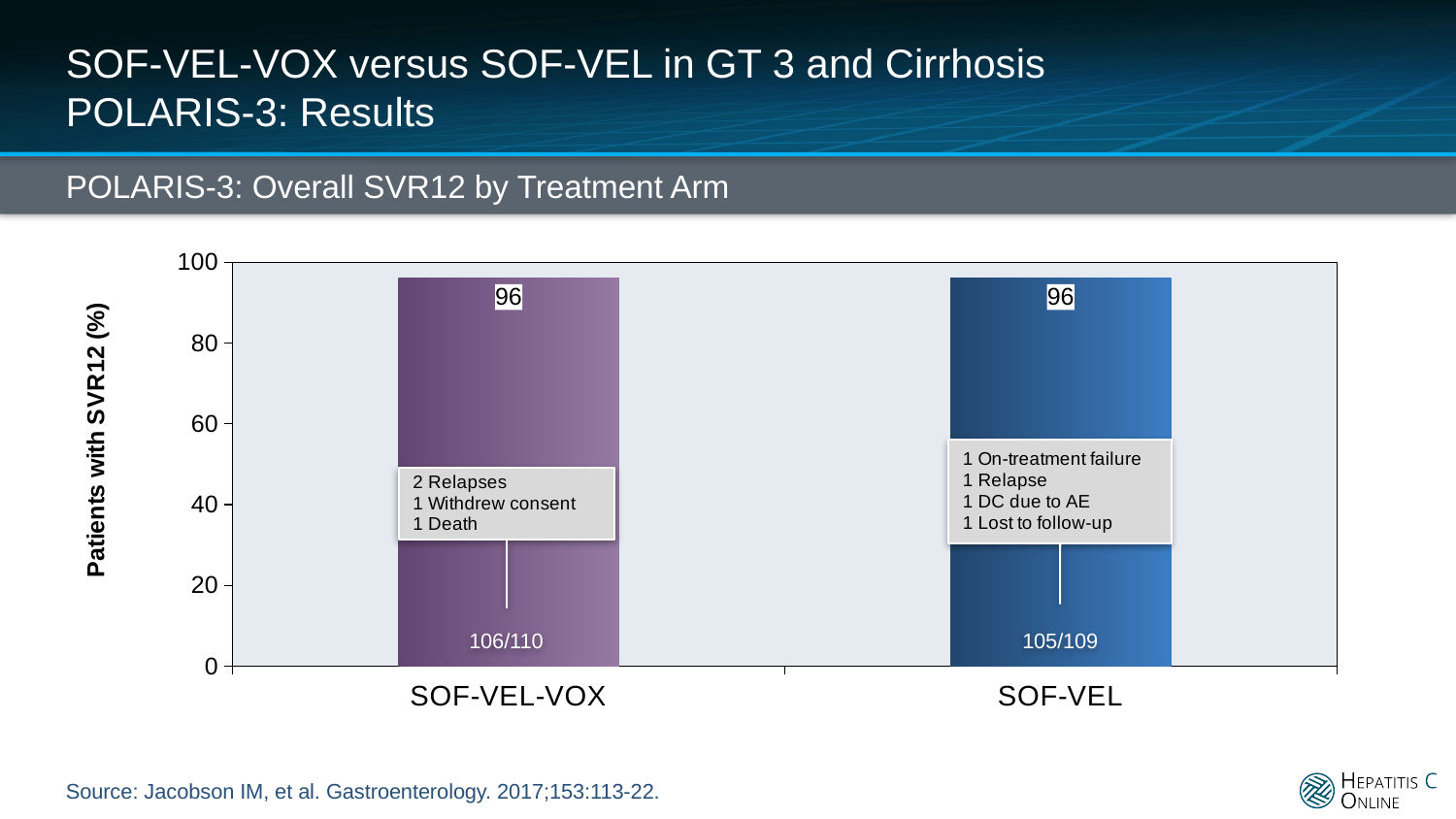
What type of chart is shown on the slide? Bar chart What is the SVR12 rate (%) for the SOF-VEL-VOX arm? 96 What fraction of patients achieved SVR12 in the SOF-VEL-VOX arm? 106/110 What is the label of the y-axis? Patients with SVR12 (%) Is the SVR12 value for SOF-VEL-VOX greater or less than 100? less How many treatment arms are shown on the chart? 2 What is the title of the chart? POLARIS-3: Overall SVR12 by Treatment Arm What fraction of patients achieved SVR12 in the SOF-VEL arm? 105/109 How many relapses are noted for the SOF-VEL-VOX arm? 2 What is the SVR12 rate (%) for the SOF-VEL arm? 96 Is the SVR12 value for SOF-VEL greater or less than 80? greater What is the difference in SVR12 rate between the SOF-VEL-VOX and SOF-VEL arms? 0